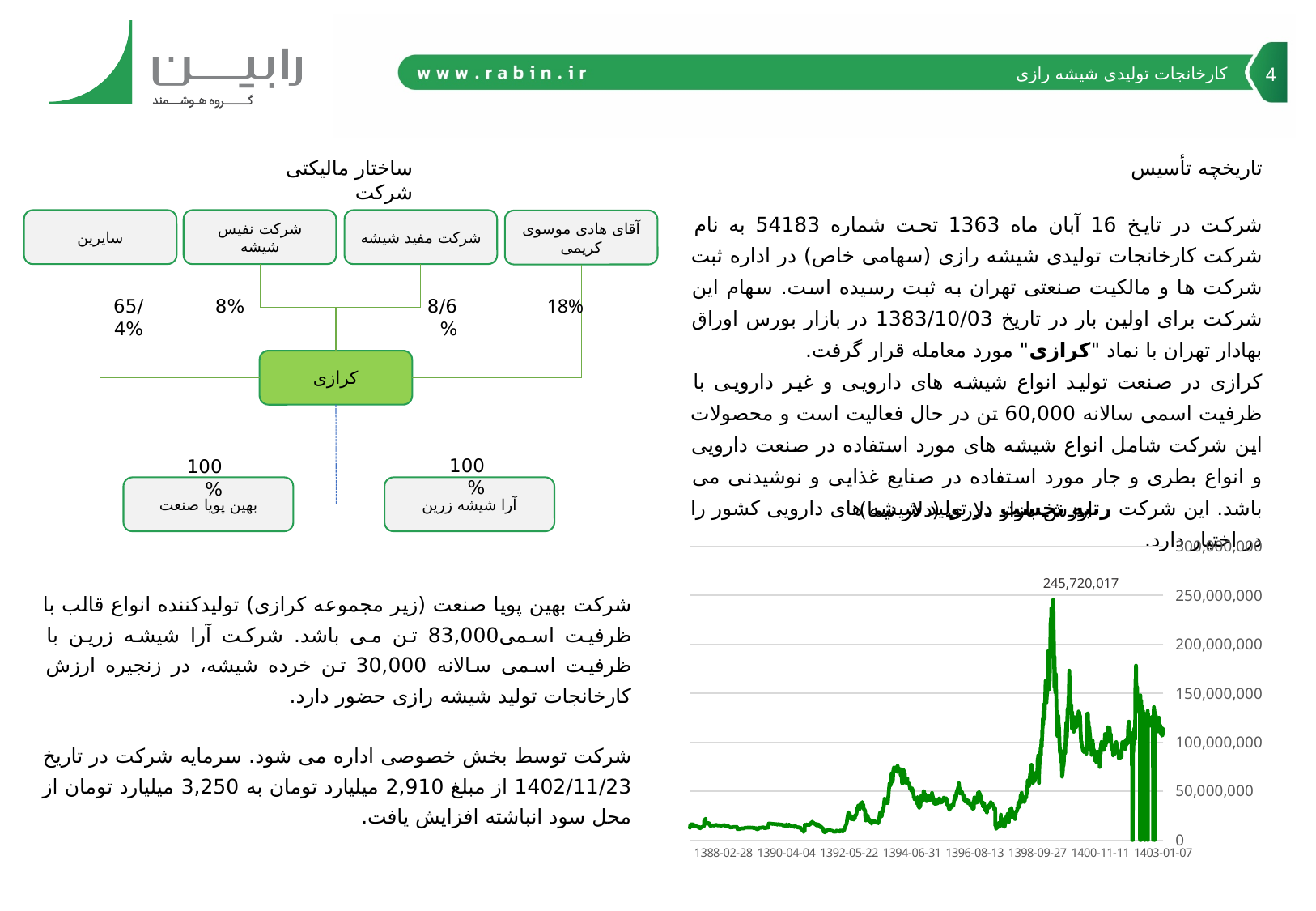
In the line chart at the bottom right, is the value at 1394-06-31 greater or less than 150,000,000? less How many date labels are shown on the x axis of the line chart at the bottom right? 8 In the line chart at the bottom right, is the value at the last date (1403-01-07) greater or less than 50,000,000? greater How many lines (series) are plotted in the line chart at the bottom right? 1 In the line chart at the bottom right, what is the peak value printed as a data label? 245,720,017 What is the highest tick value shown on the y axis of the line chart at the bottom right? 300,000,000 What colour is the line in the chart at the bottom right of the slide? green In the line chart at the bottom right, does the value overall rise or fall from the first date to the last date? rise In the line chart at the bottom right, is the value at the last date (1403-01-07) greater or less than 150,000,000? less What kind of chart is shown at the bottom right of the slide? line chart In the line chart at the bottom right, which is larger: the value at 1388-02-28 or the value at 1403-01-07? 1403-01-07